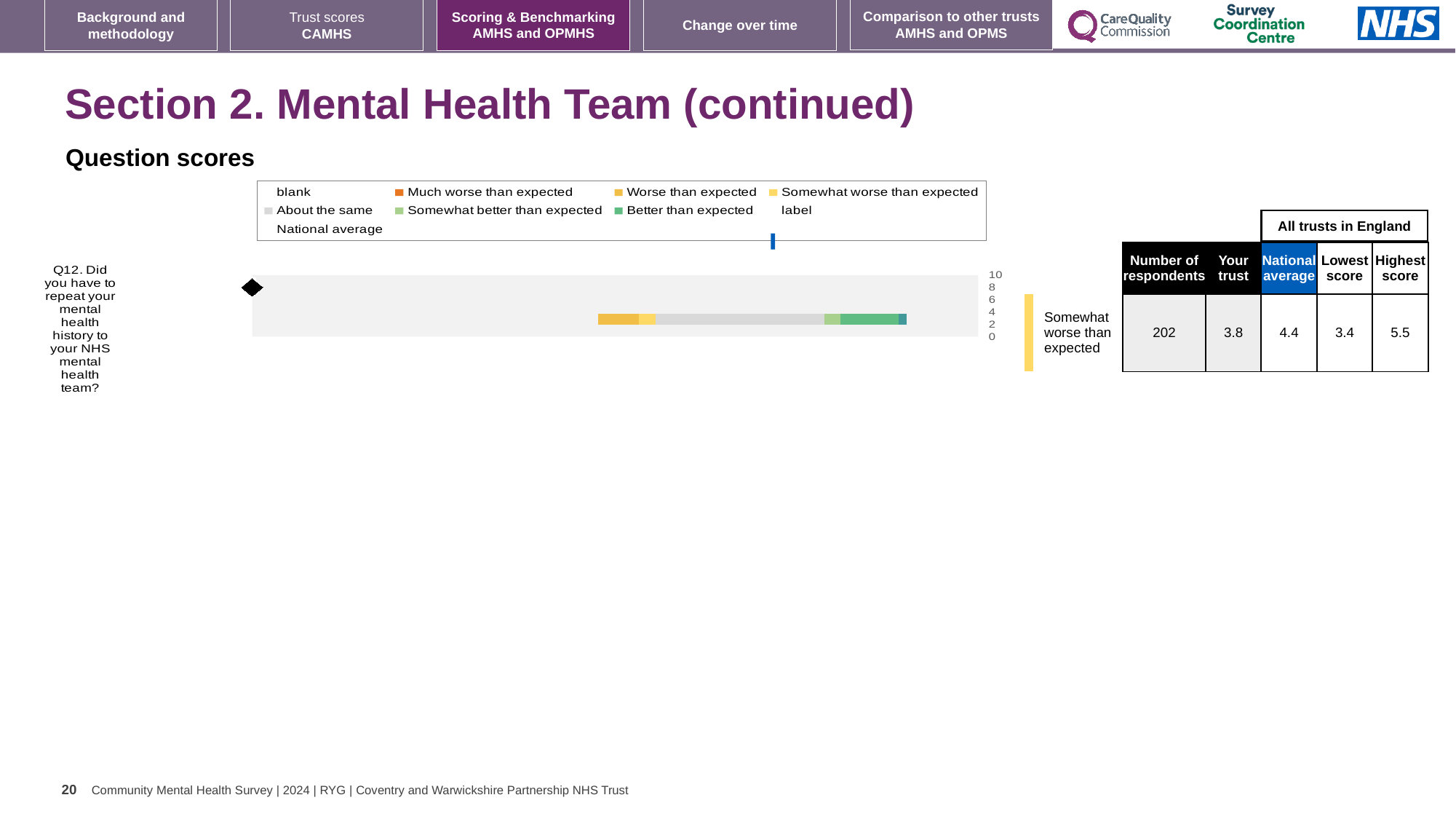
What kind of chart is used to show the Q12 question score? bar chart For Q12, what is the difference between the highest score (5.5) and the lowest score (3.4) among all trusts in England? 2.1 What is the number of respondents for Q12 in the table beside the chart? 202 What benchmark rating label is shown to the right of the Q12 bar? Somewhat worse than expected How many survey questions are plotted in the chart? 1 What is the 'Your trust' score for Q12 in the table beside the chart? 3.8 For Q12, which is larger: the 'Your trust' score or the national average? National average Which question is plotted in the chart? Q12. Did you have to repeat your mental health history to your NHS mental health team? For Q12, what is the difference between the national average (4.4) and the 'Your trust' score (3.8)? 0.6 What is the highest score among all trusts in England for Q12? 5.5 What is the national average score for Q12 in the table beside the chart? 4.4 What is the lowest score among all trusts in England for Q12? 3.4